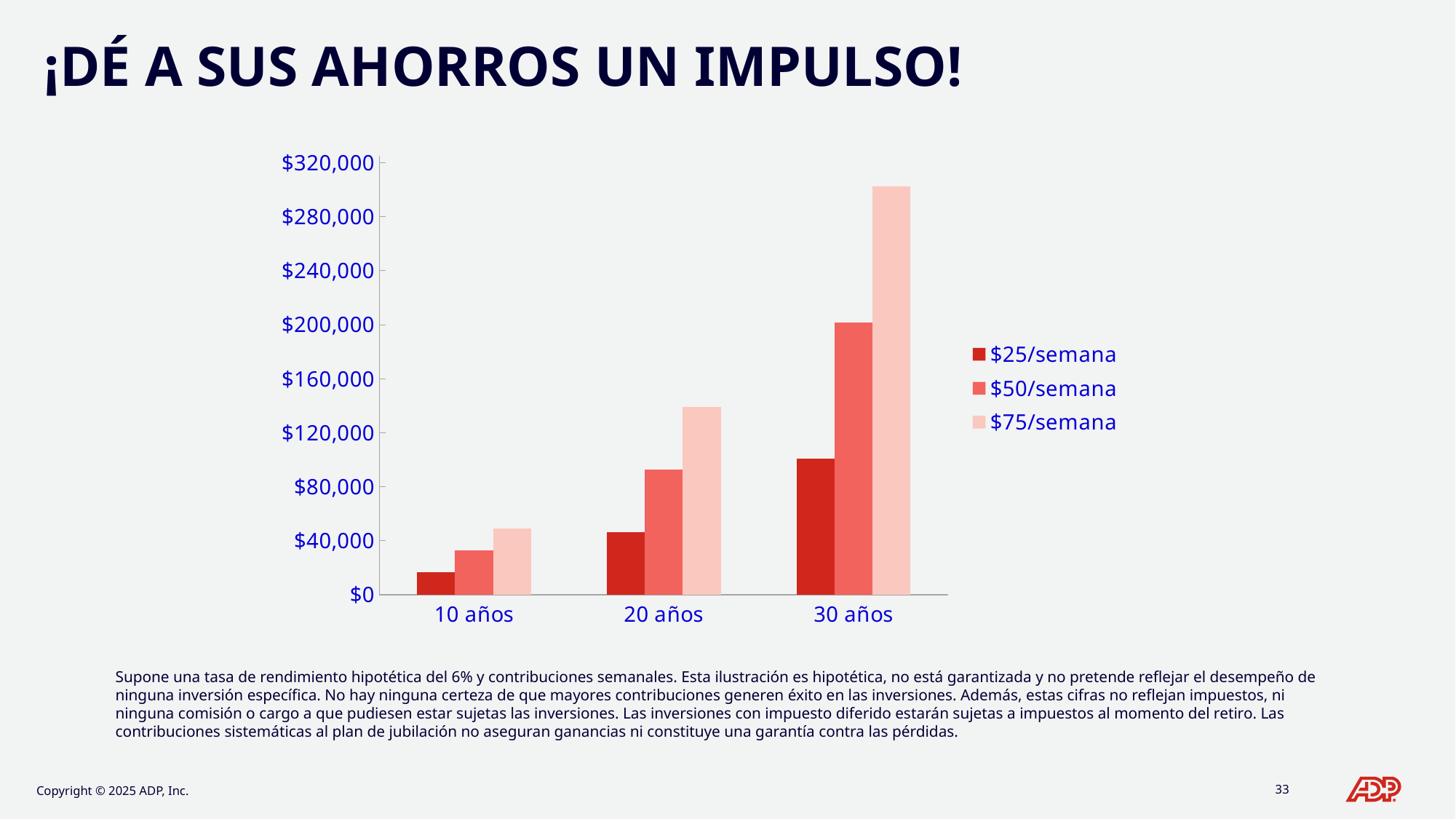
Which category has the highest value for the $75/semana series? 30 años How many categories are shown on the x axis? 3 Which is larger at 20 años: the $50/semana value or the $75/semana value? $75/semana How many series does the legend list? 3 Is the value for $25/semana at 30 años greater or less than $80,000? greater Is the value for $75/semana at 30 años greater or less than $280,000? greater Is the value for $75/semana at 20 años greater or less than $120,000? greater Do the values for the $50/semana series rise or fall from 10 años to 30 años? rise Which category has the lowest value for the $25/semana series? 10 años What kind of chart is shown on the slide? bar chart